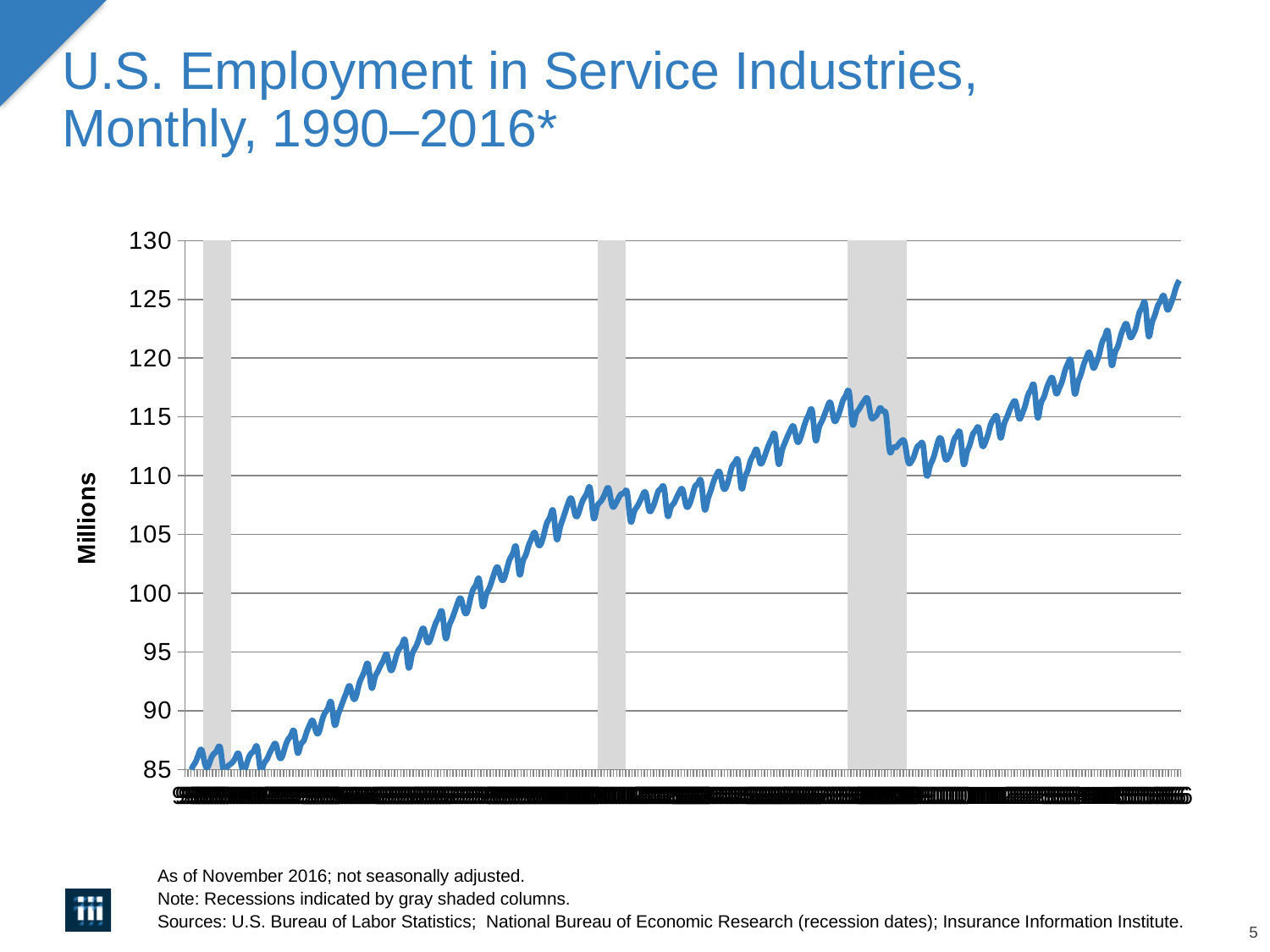
Is the value at the left end of the line (1990) greater or less than 90? less What is the label on the vertical axis of the chart? Millions Do the values generally rise or fall from left to right across the chart? rise What is the highest value shown on the vertical axis? 130 Is the peak reached just before the third gray shaded column greater or less than 120? less How many gray shaded recession columns appear on the chart? 3 What kind of chart is shown on the slide? line chart Is the value at the right end of the line (late 2016) greater or less than 120? greater